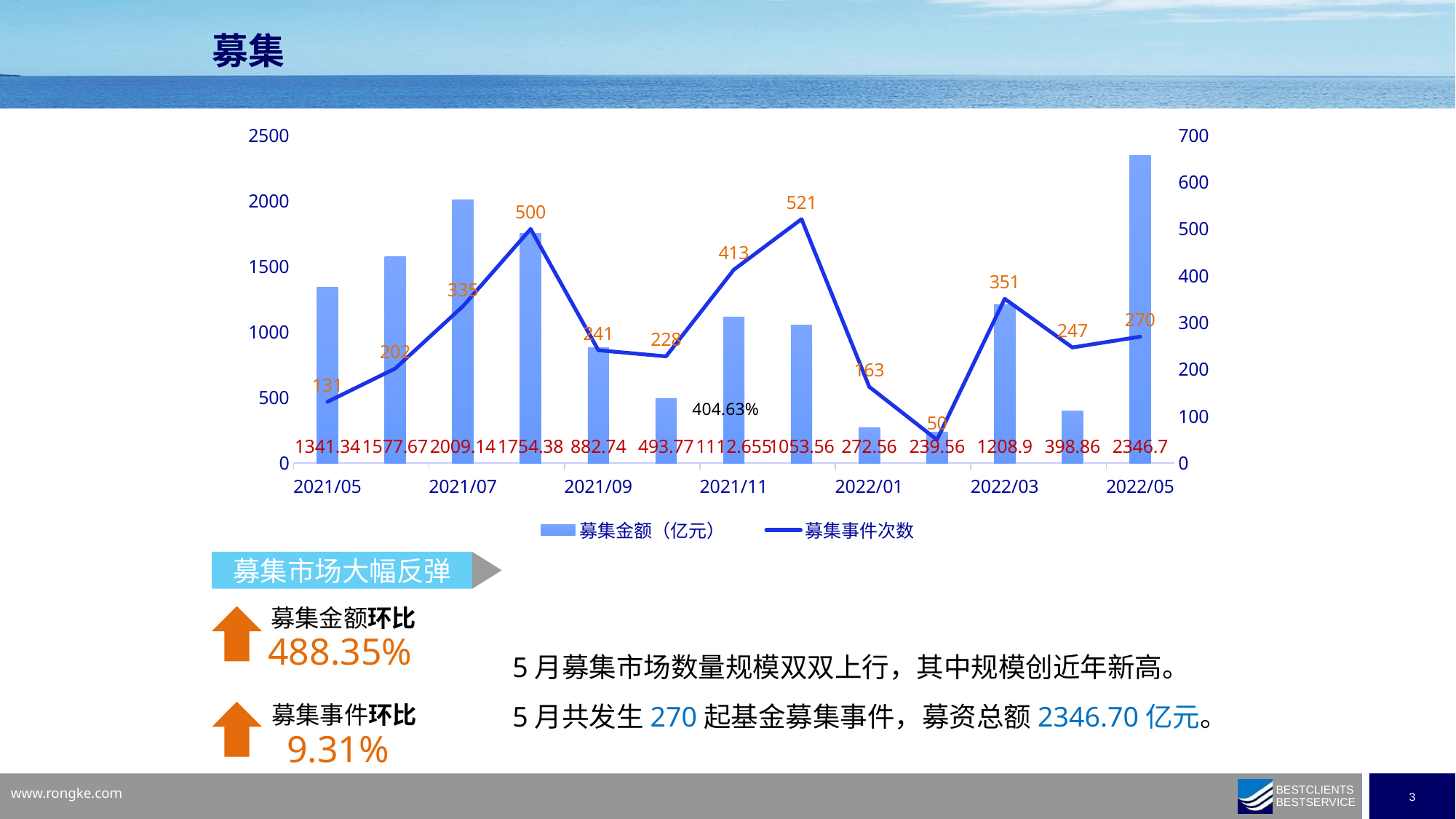
What is the 募集金额（亿元） value for 2022/05? 2346.7 What is the lowest 募集事件次数 value shown on the chart? 50 What is the 募集金额（亿元） value for 2021/09? 882.74 What kind of chart is shown on the slide? Combined bar and line chart What is the 募集事件次数 value for 2022/03? 351 Which month has the highest 募集金额（亿元）? 2022/05 How many series does the legend list? 2 What is the difference in 募集金额（亿元） between 2022/05 and 2021/05? 1005.36 What is the 募集事件次数 value for 2021/05? 131 How many months are plotted on the x axis? 13 Which has the larger 募集金额（亿元）, 2021/07 or 2021/09? 2021/07 What is the highest 募集事件次数 value shown on the chart? 521